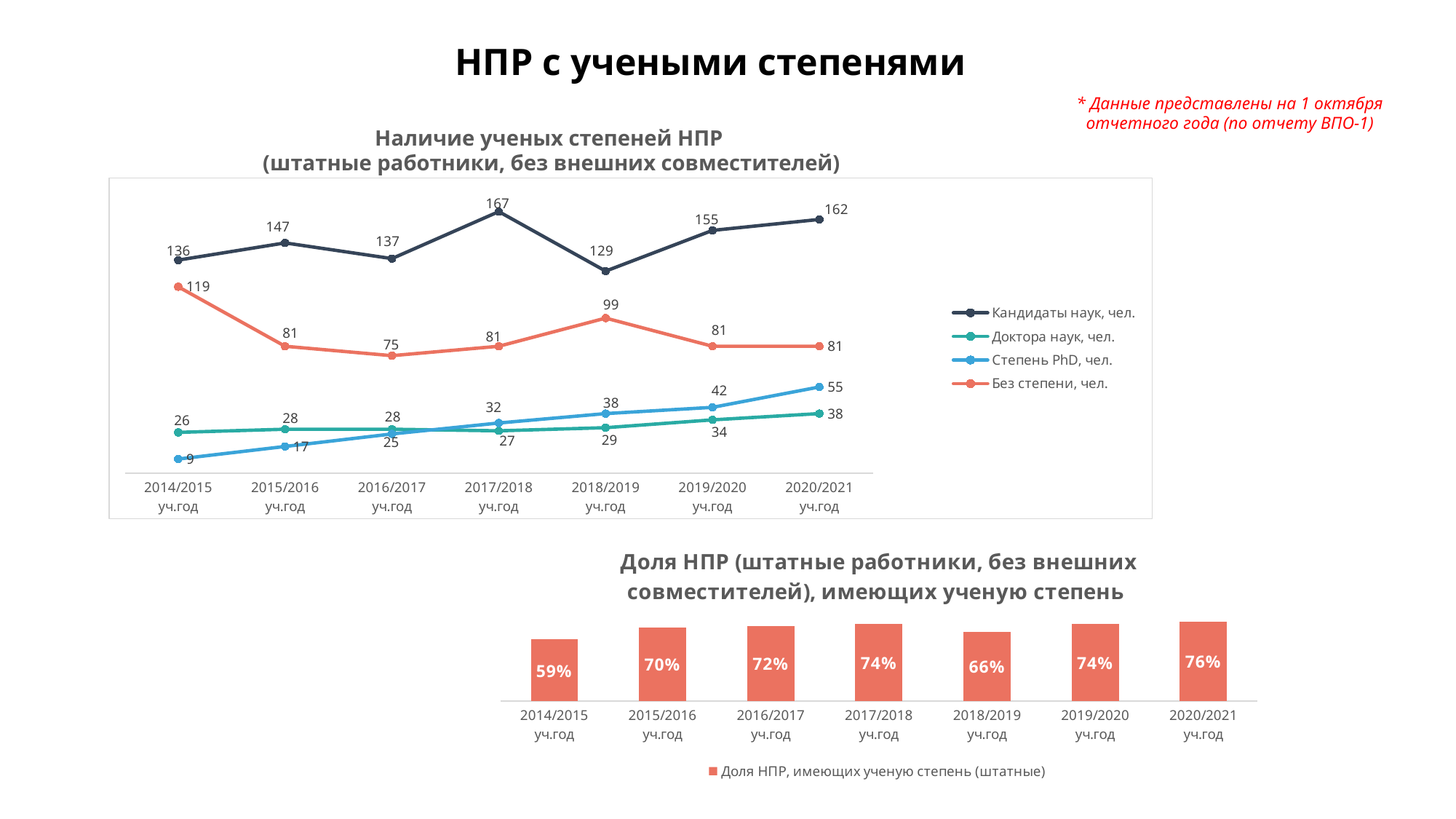
What type of chart is the lower chart on the slide? bar chart In the line chart 'Наличие ученых степеней НПР', what is the value for 'Степень PhD, чел.' in 2020/2021 уч.год? 55 In the line chart 'Наличие ученых степеней НПР', how many series does the legend list? 4 In the bar chart 'Доля НПР ... имеющих ученую степень', what is the difference between 2020/2021 and 2014/2015? 17% In the line chart 'Наличие ученых степеней НПР', what is the difference between 'Кандидаты наук, чел.' and 'Доктора наук, чел.' in 2020/2021 уч.год? 124 In the line chart 'Наличие ученых степеней НПР', in which year is 'Кандидаты наук, чел.' lowest? 2018/2019 уч.год In the line chart 'Наличие ученых степеней НПР', does 'Степень PhD, чел.' rise or fall from 2014/2015 to 2020/2021? rise In the line chart 'Наличие ученых степеней НПР', what is the value for 'Кандидаты наук, чел.' in 2017/2018 уч.год? 167 In the bar chart 'Доля НПР ... имеющих ученую степень', how many years are shown? 7 In the bar chart 'Доля НПР ... имеющих ученую степень', which year has the highest value? 2020/2021 уч.год In the bar chart 'Доля НПР ... имеющих ученую степень', what is the value for 2018/2019 уч.год? 66% In the line chart 'Наличие ученых степеней НПР', what is the value for 'Без степени, чел.' in 2014/2015 уч.год? 119